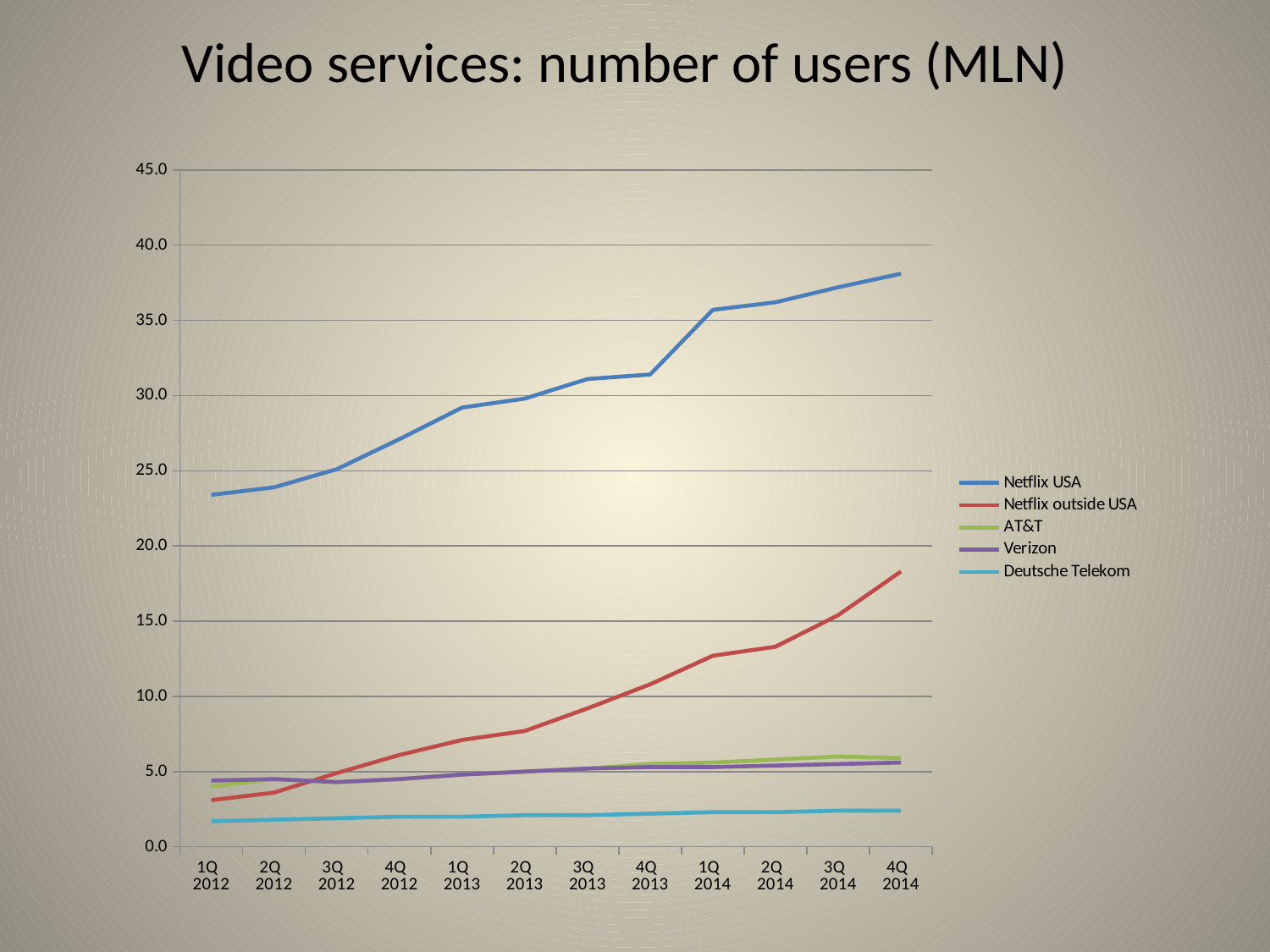
What is the title of the chart? Video services: number of users (MLN) How many quarters are plotted along the x axis? 12 Is the value for Netflix outside USA in 4Q 2014 greater or less than 15.0? greater How many series does the legend list? 5 In 1Q 2012, which is larger: Verizon or Netflix outside USA? Verizon What kind of chart is shown on the slide? line chart Does the Netflix USA line rise or fall from 1Q 2012 to 4Q 2014? rise Which series has the lowest value in 4Q 2014? Deutsche Telekom Is the value for Netflix USA in 4Q 2014 greater or less than 35.0? greater Which series has the highest value in 4Q 2014? Netflix USA Is the value for Deutsche Telekom in 4Q 2014 greater or less than 5.0? less